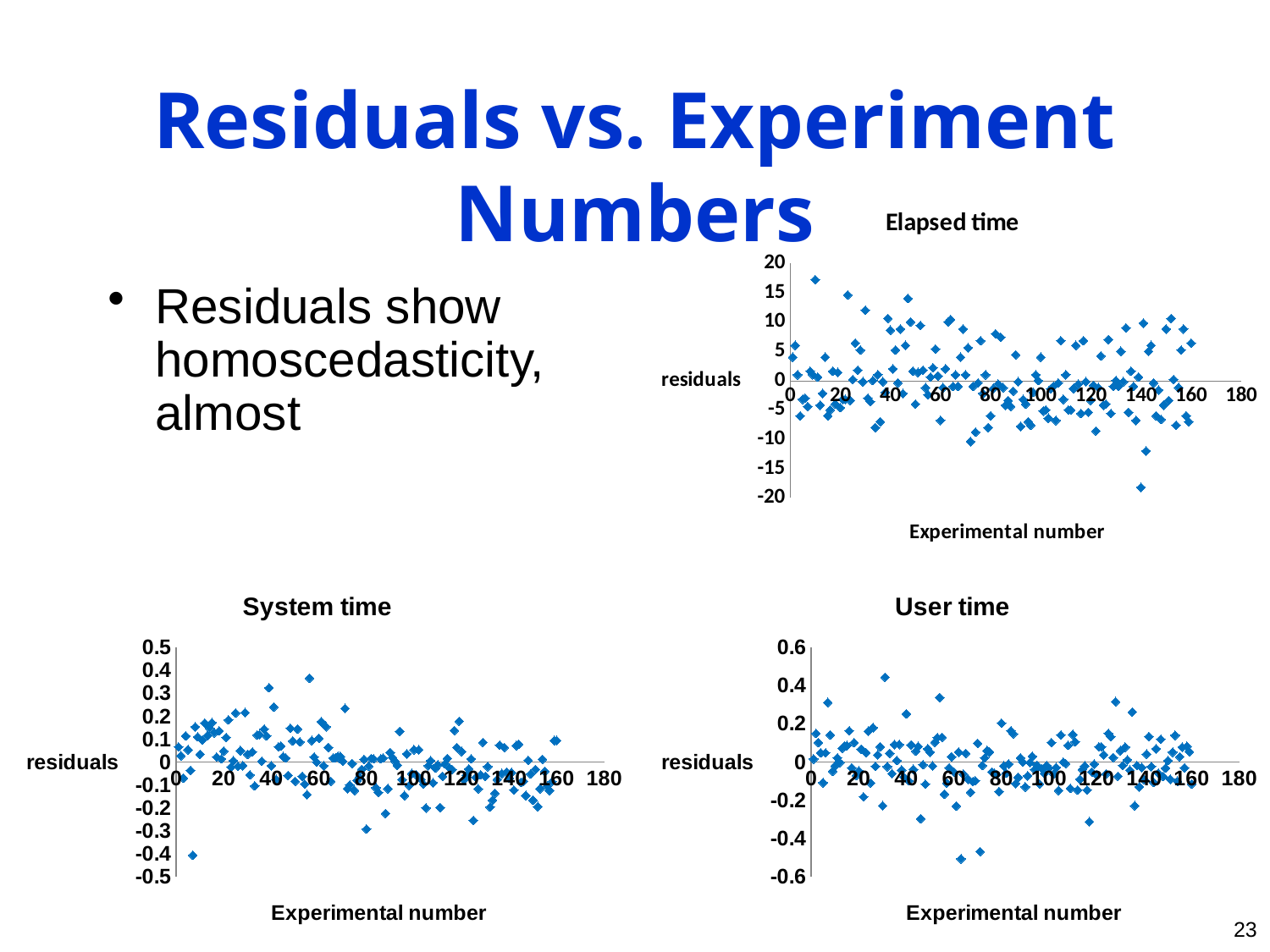
In the "Elapsed time" chart, is the highest residual value greater or less than 15? greater In the "User time" chart, is the highest residual value greater or less than 0.3? greater In the "System time" chart, is the lowest residual value greater or less than -0.3? less How many charts are shown on the slide? 3 What kind of chart is the "Elapsed time" chart? scatter chart What is the title of the chart at the top right of the slide? Elapsed time What is the maximum value shown on the x-axis of the "Elapsed time" chart? 180 What is the x-axis title of the "System time" chart? Experimental number What is the maximum value shown on the y-axis of the "User time" chart? 0.6